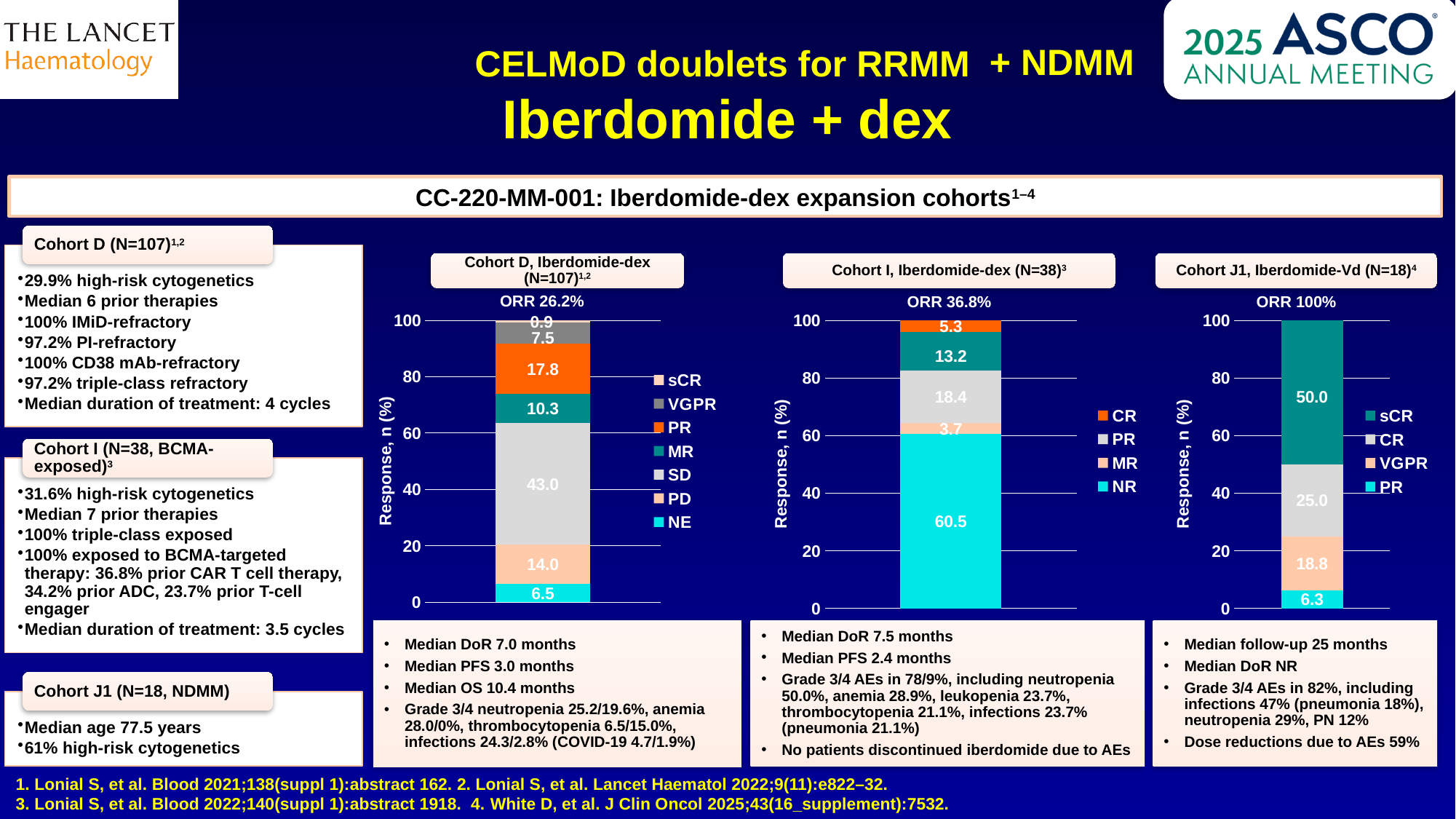
How many series does the legend of the Cohort D, Iberdomide-dex (N=107) chart list? 7 In the Cohort J1, Iberdomide-Vd (N=18) chart, what is the value for PR? 6.3 In the Cohort I, Iberdomide-dex (N=38) chart, what is the value for NR? 60.5 What kind of chart is used for the Cohort D, Iberdomide-dex (N=107) response data? Stacked bar chart What ORR is shown above the Cohort J1, Iberdomide-Vd (N=18) chart? ORR 100% In the Cohort D, Iberdomide-dex (N=107) chart, what is the difference between the PD value and the NE value? 7.5 In the Cohort J1, Iberdomide-Vd (N=18) chart, what is the value for sCR? 50.0 In the Cohort D, Iberdomide-dex (N=107) chart, what is the value for PR? 17.8 In the Cohort D, Iberdomide-dex (N=107) chart, what is the value for SD? 43.0 In the Cohort D, Iberdomide-dex (N=107) chart, which response category has the largest segment? SD In the Cohort I, Iberdomide-dex (N=38) chart, what is the value for CR? 5.3 In the Cohort J1, Iberdomide-Vd (N=18) chart, which is larger, sCR or CR? sCR